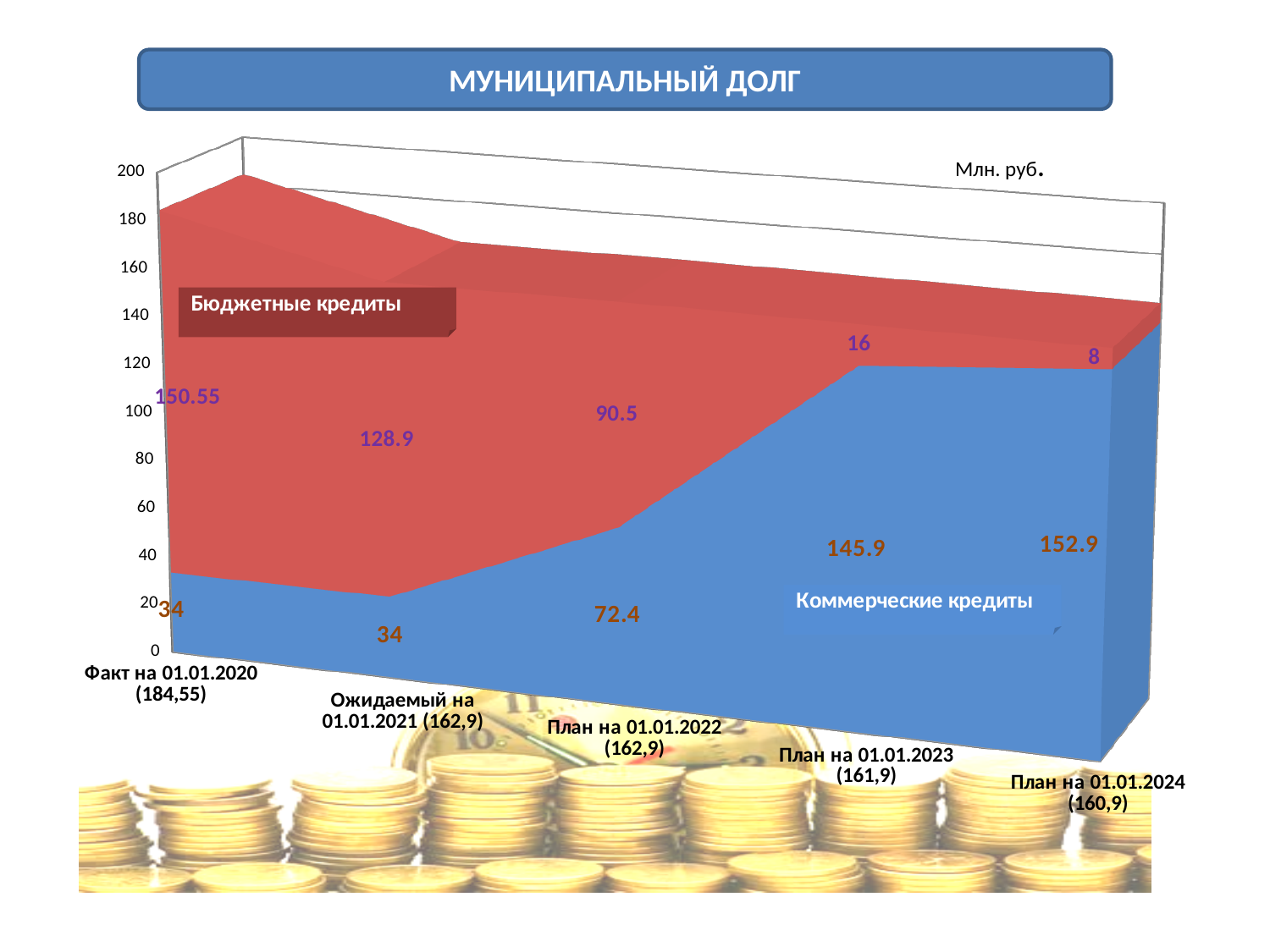
What kind of chart is shown on the slide? Area chart What is the value of Бюджетные кредиты for Факт на 01.01.2020? 150.55 What is the value of Коммерческие кредиты for План на 01.01.2022? 72.4 In which period is Бюджетные кредиты lowest? План на 01.01.2024 What is the value of Бюджетные кредиты for План на 01.01.2024? 8 Which is larger for План на 01.01.2023: Бюджетные кредиты or Коммерческие кредиты? Коммерческие кредиты What is the value of Коммерческие кредиты for План на 01.01.2023? 145.9 How many series does the chart show? 2 What is the difference between Бюджетные кредиты for Ожидаемый на 01.01.2021 and for План на 01.01.2022? 38.4 Do the values of Бюджетные кредиты rise or fall from Факт на 01.01.2020 to План на 01.01.2024? Fall How many periods are shown on the x axis? 5 In which period is Коммерческие кредиты highest? План на 01.01.2024